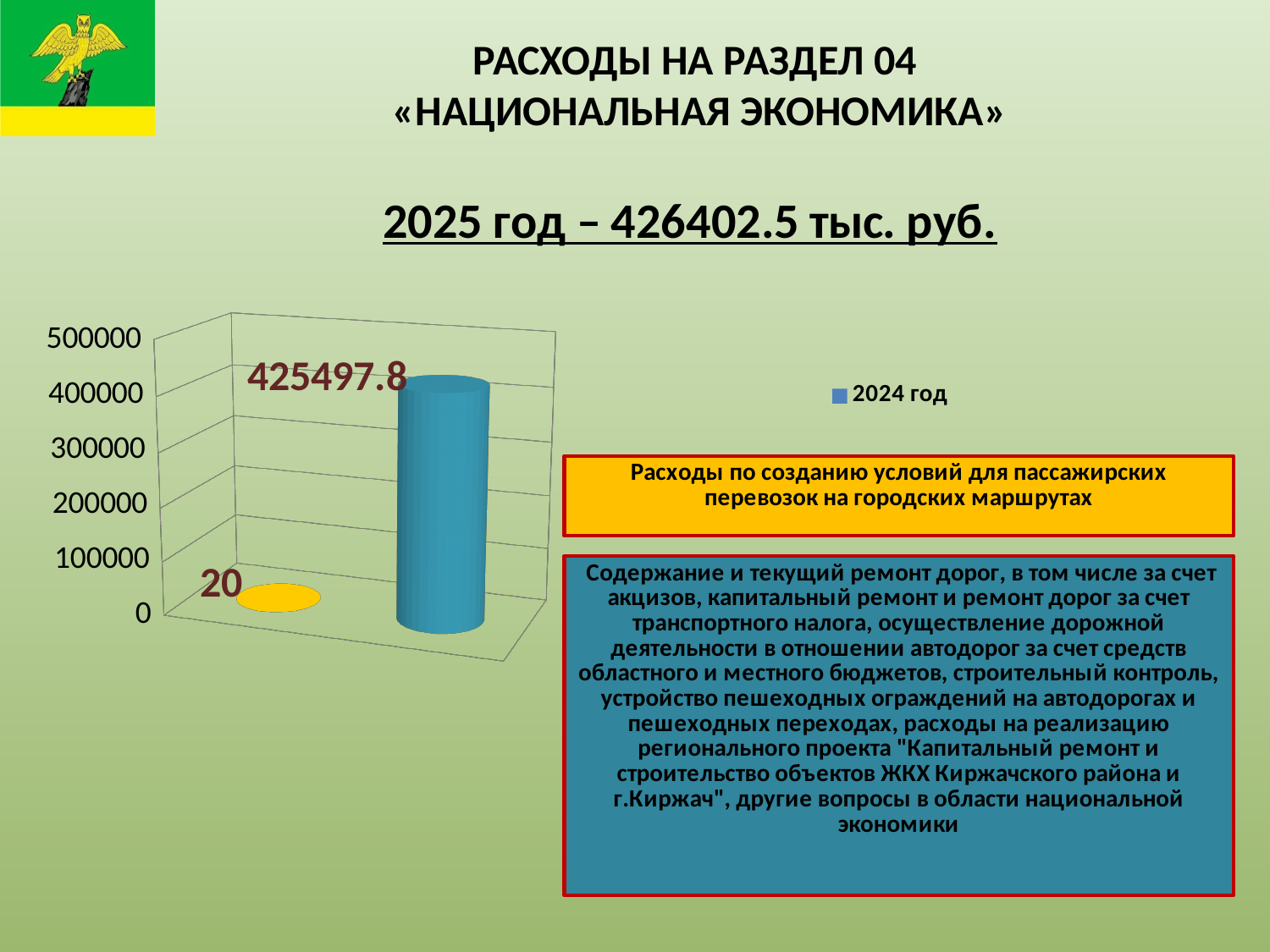
What value is labelled on the tall blue bar in the chart? 425497.8 Is the value of the blue bar greater or less than 400000? greater What is the entry shown in the chart legend? 2024 год Which bar in the chart has the highest value? The blue bar (425497.8) How many bars are plotted in the chart? 2 Which is larger, the value of the blue bar or the value of the yellow bar? The blue bar What is the difference between the blue bar's value and the yellow bar's value? 425477.8 Is the value of the yellow bar greater or less than 100000? less What kind of chart is shown on the slide? Bar chart Which bar in the chart has the lowest value? The yellow bar (20) How many entries does the chart legend list? 1 What value is labelled on the small yellow bar in the chart? 20